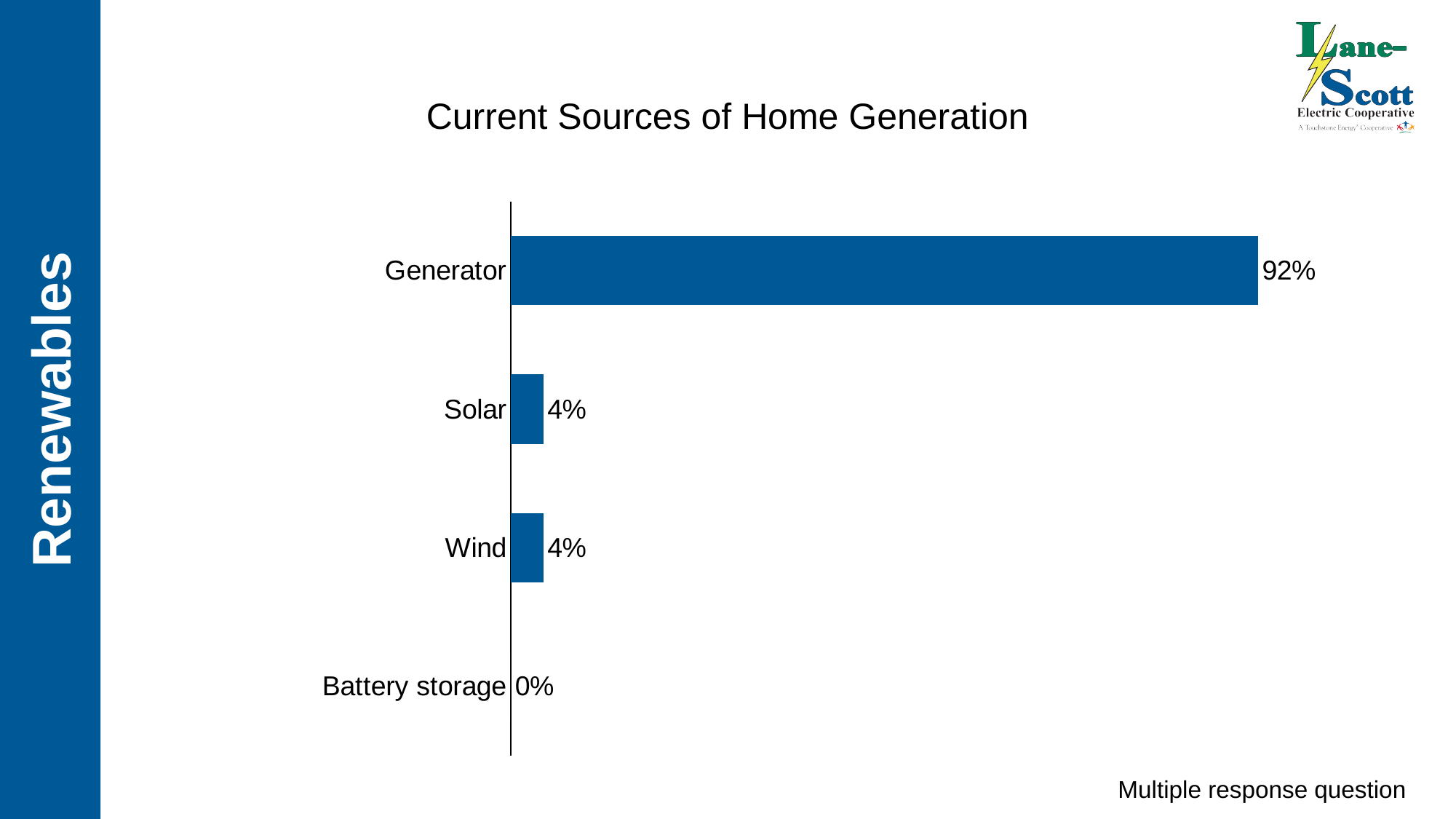
What kind of chart is shown on the slide? Bar chart How many categories are shown in the chart? 4 Which category has the highest value? Generator What is the value for Solar? 4% What is the difference between the values for Wind and Battery storage? 4% What is the value for Wind? 4% Which is larger, the value for Generator or the value for Wind? Generator What is the value for Generator? 92% What is the value for Battery storage? 0% What is the difference between the values for Generator and Solar? 88% Which category has the lowest value? Battery storage What is the title of the chart? Current Sources of Home Generation